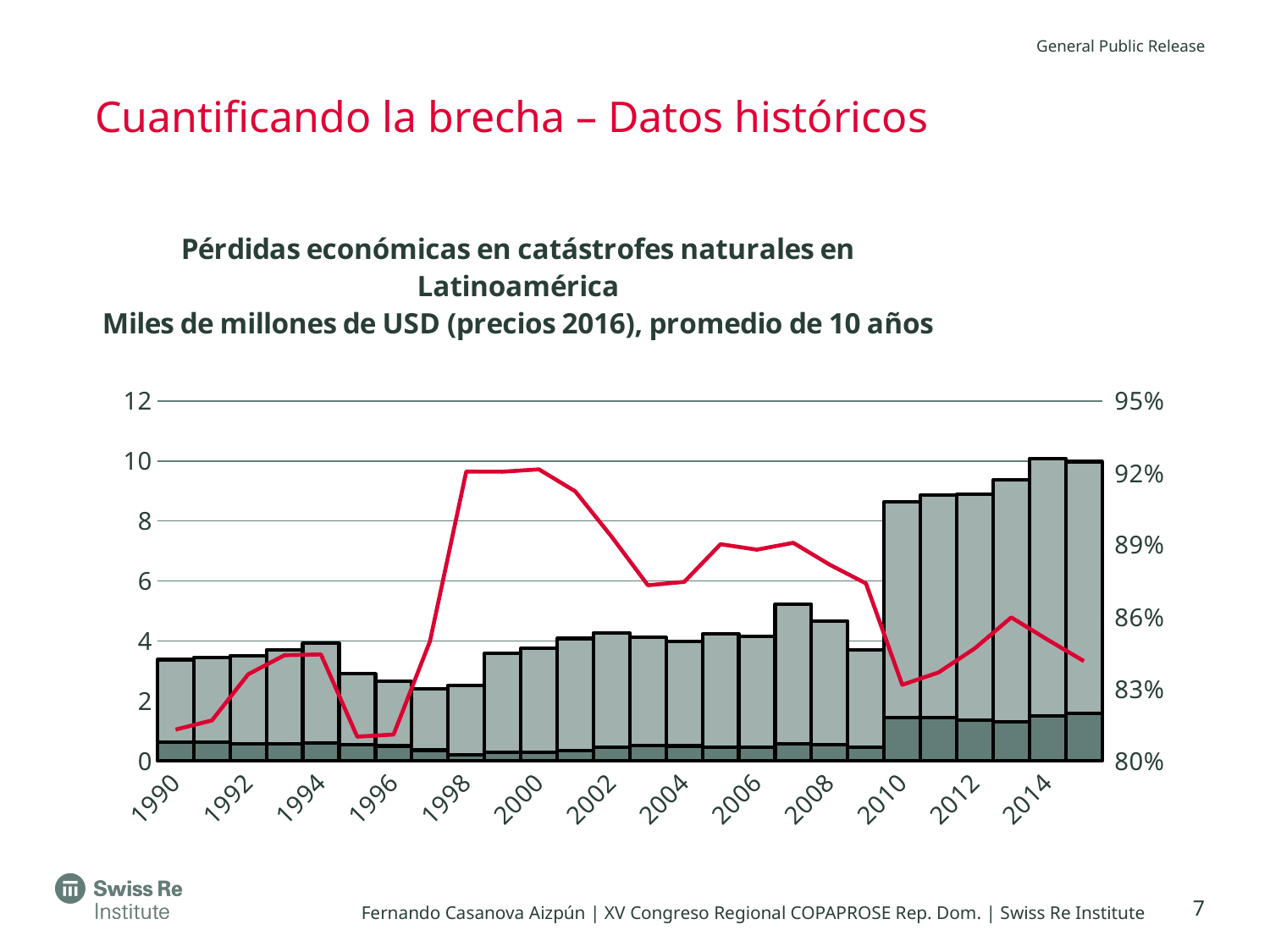
Which year has the taller total bar, 2000 or 2010? 2010 Which year has the taller total bar, 2008 or 2009? 2008 Is the total bar value for 1990 greater or less than 4? less Do the total bar values rise or fall from 2009 to 2014? rise Is the total bar value for 2008 greater or less than 4? greater Is the red line value for 1998 greater or less than 89%? greater What kind of chart is shown on the slide? A bar chart combined with a line chart What is the title of the chart? Pérdidas económicas en catástrofes naturales en Latinoamérica How many bars (years) are plotted in the chart? 26 What unit does the chart subtitle say the bars are measured in? Miles de millones de USD (precios 2016), promedio de 10 años